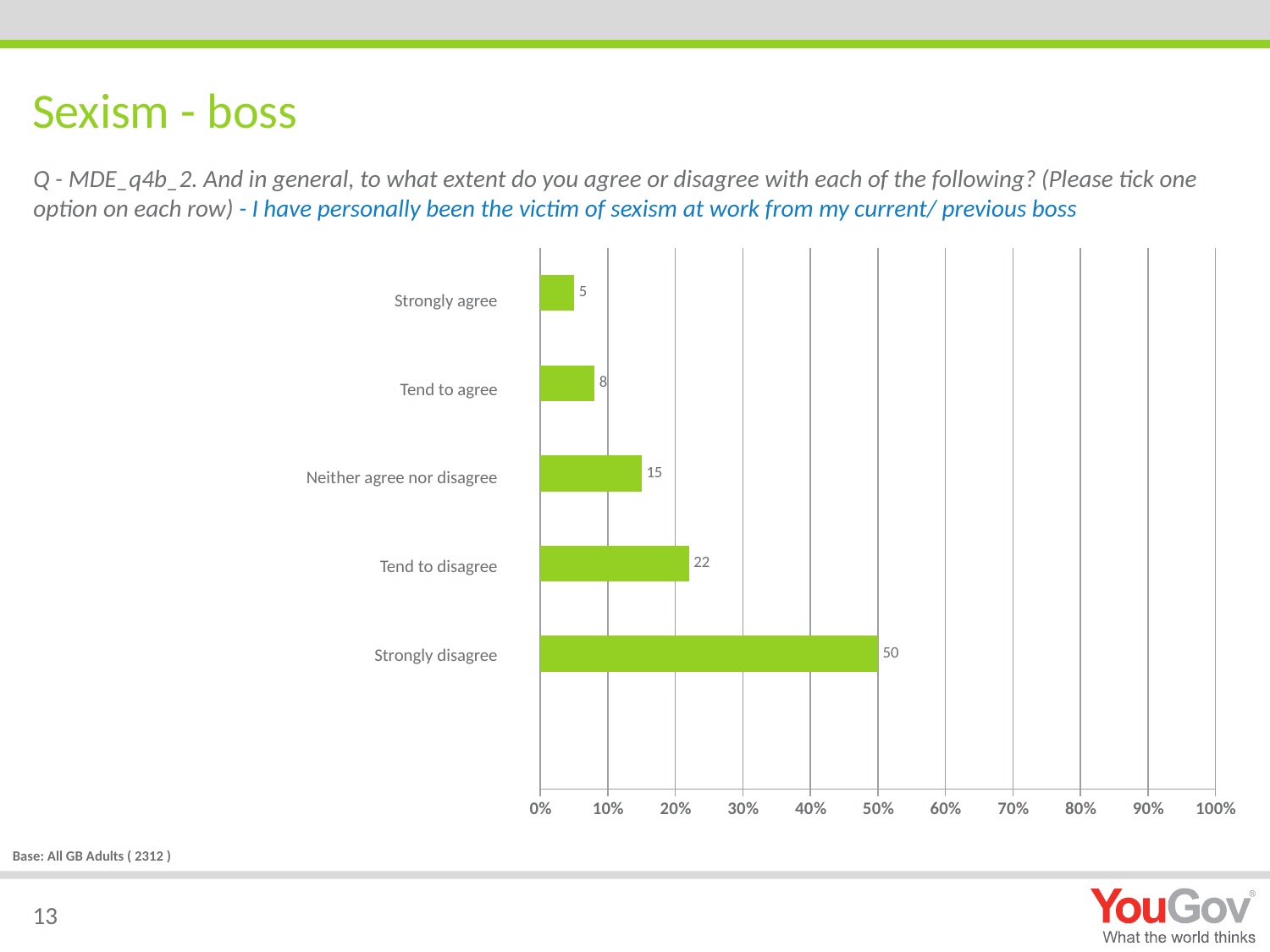
Is the value for Tend to disagree greater or less than 30%? less What is the value for Strongly disagree? 50 What is the maximum value shown on the horizontal axis? 100% What is the combined value of Strongly agree and Tend to agree? 13 What kind of chart is shown on the slide? bar chart Which category has the highest value? Strongly disagree What is the difference between the values for Strongly disagree and Tend to disagree? 28 Which is larger, the value for Tend to agree or the value for Neither agree nor disagree? Neither agree nor disagree Which category has the lowest value? Strongly agree What is the value for Tend to agree? 8 How many categories are shown in the chart? 5 What is the value for Neither agree nor disagree? 15